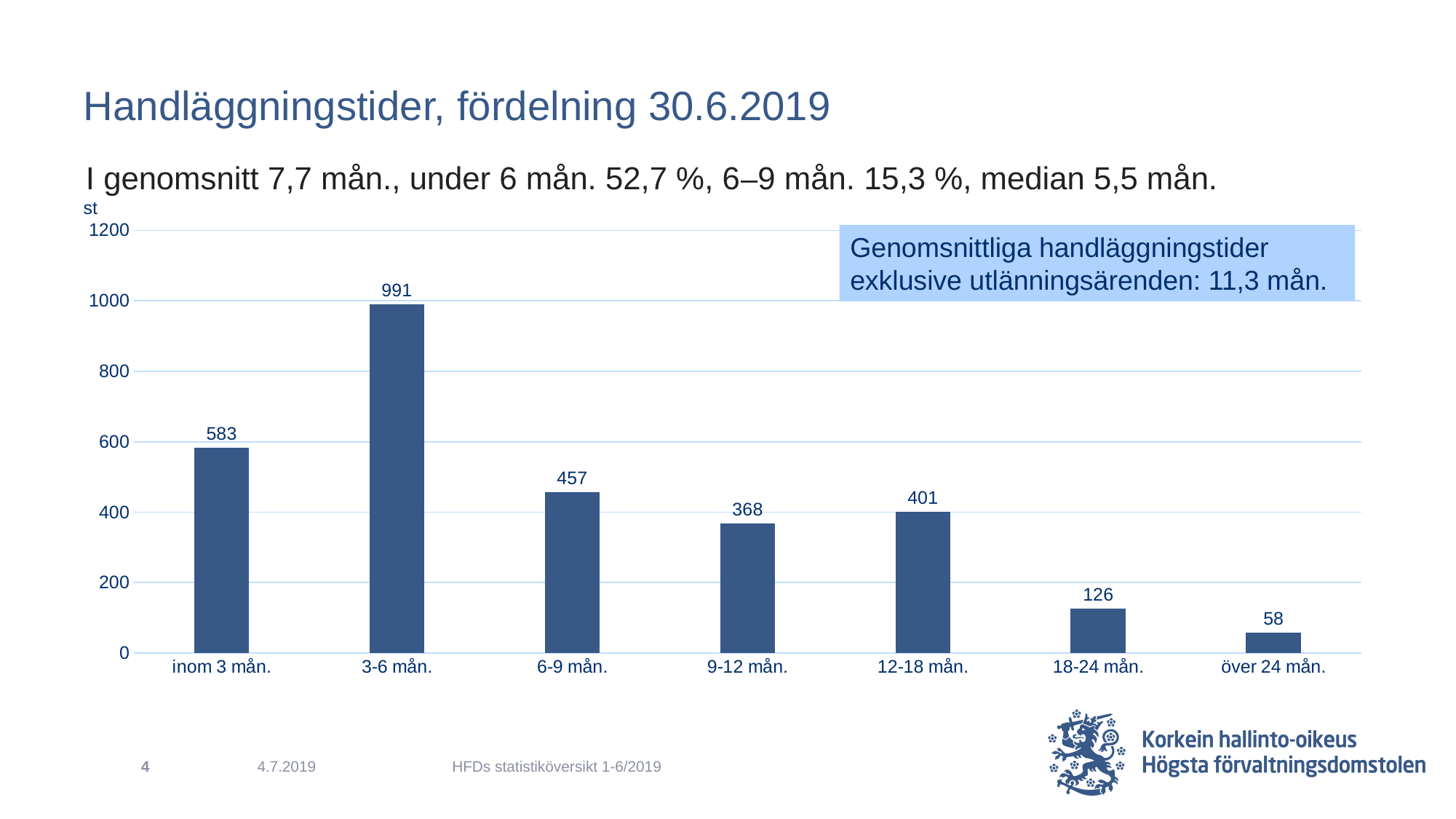
Which category has the lowest value? över 24 mån. Is the value for '18-24 mån.' greater or less than 200? less What is the difference between the values for '3-6 mån.' and 'inom 3 mån.'? 408 What is the title of the slide containing the chart? Handläggningstider, fördelning 30.6.2019 What is the value for the '3-6 mån.' category? 991 Which category has the highest value? 3-6 mån. Which is larger, the value for '12-18 mån.' or the value for '9-12 mån.'? 12-18 mån. What is the value for the 'över 24 mån.' category? 58 What is the value for the '12-18 mån.' category? 401 How many categories are shown on the x axis? 7 What kind of chart is shown on the slide? bar chart What is the difference between the values for '6-9 mån.' and '9-12 mån.'? 89